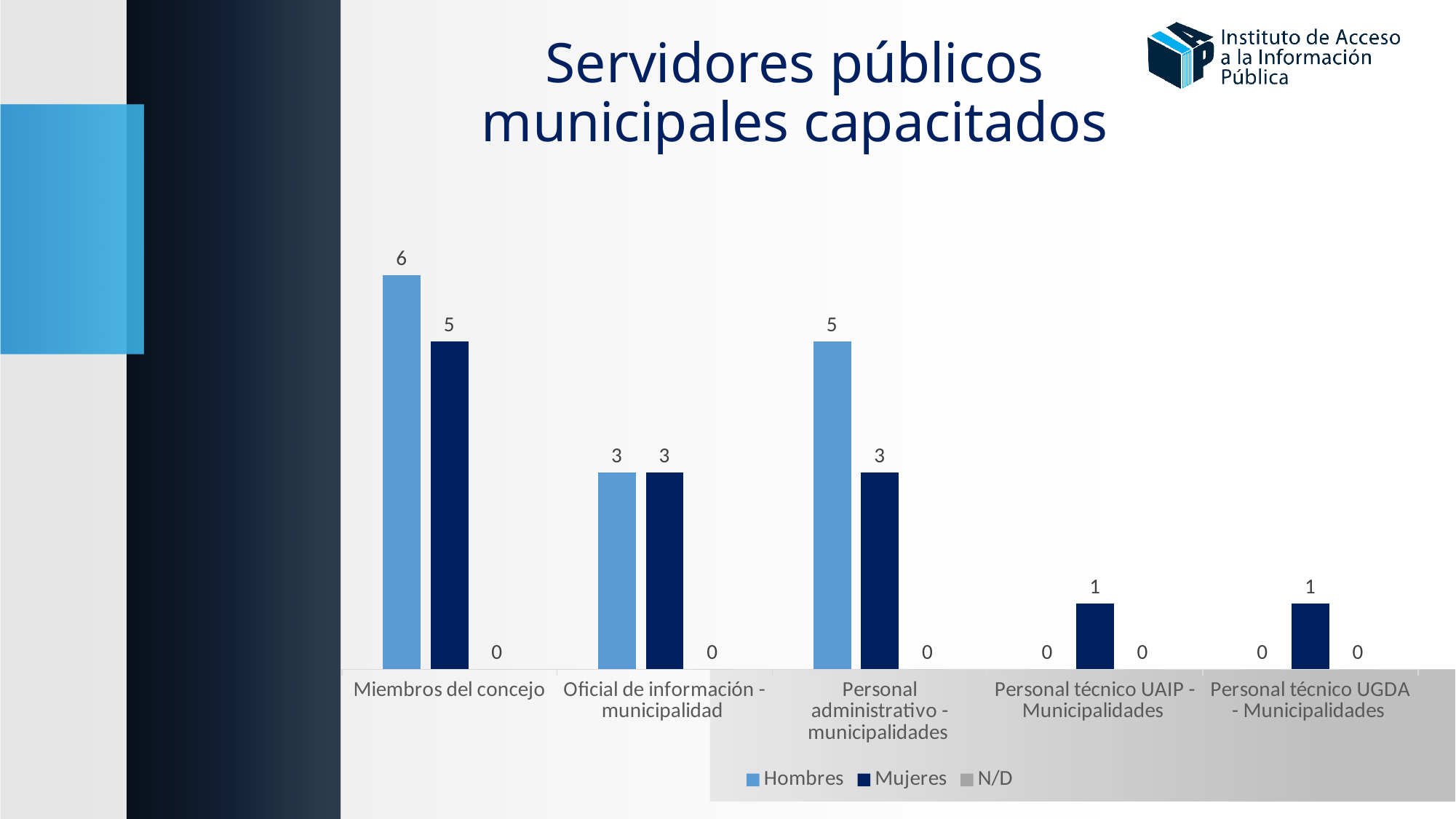
Which category has the lowest Mujeres value? Personal técnico UAIP - Municipalidades and Personal técnico UGDA - Municipalidades (both 1) How many series does the legend list? 3 What is the difference between the Hombres and Mujeres values for Miembros del concejo? 1 What is the Mujeres value for Personal administrativo - municipalidades? 3 How many categories are shown on the x axis? 5 What is the Hombres value for Miembros del concejo? 6 What is the Mujeres value for Personal técnico UAIP - Municipalidades? 1 Which category has the highest Hombres value? Miembros del concejo Which is larger for Personal administrativo - municipalidades: Hombres or Mujeres? Hombres What is the title of the chart? Servidores públicos municipales capacitados What is the Hombres value for Personal técnico UGDA - Municipalidades? 0 What kind of chart is shown on the slide? Bar chart